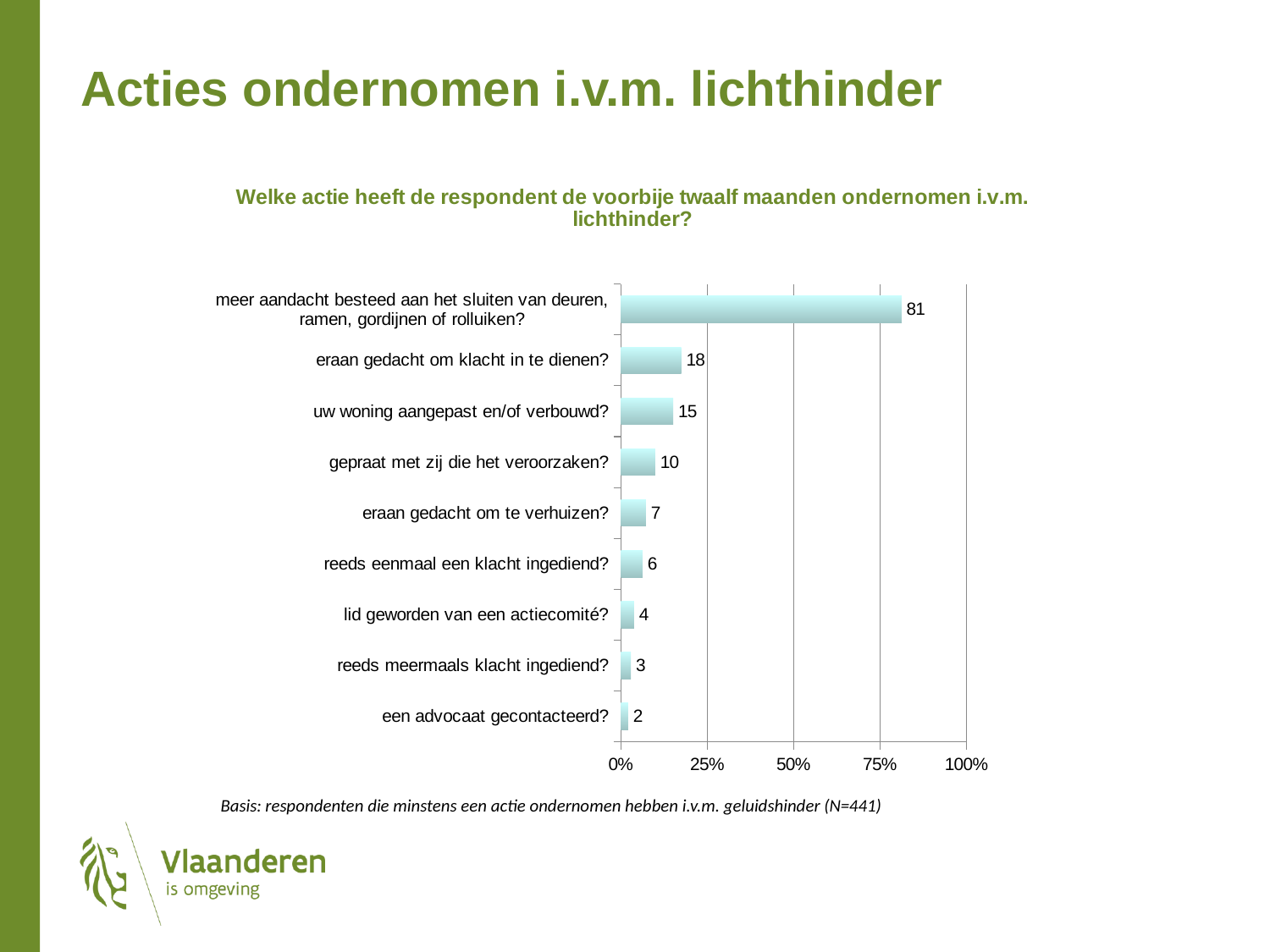
What is the difference between the values for 'eraan gedacht om klacht in te dienen?' and 'uw woning aangepast en/of verbouwd?' 3 What kind of chart is shown on the slide? bar chart Is the value for 'meer aandacht besteed aan het sluiten van deuren, ramen, gordijnen of rolluiken?' greater or less than 75%? greater What value is shown for 'een advocaat gecontacteerd?' 2 What value is shown for 'gepraat met zij die het veroorzaken?' 10 What value is shown for 'eraan gedacht om klacht in te dienen?' 18 Which category has the lowest value? een advocaat gecontacteerd? What value is shown for 'uw woning aangepast en/of verbouwd?' 15 How many categories are shown in the chart? 9 Which category has the highest value? meer aandacht besteed aan het sluiten van deuren, ramen, gordijnen of rolluiken? Which is larger: the value for 'eraan gedacht om te verhuizen?' or 'reeds eenmaal een klacht ingediend?' eraan gedacht om te verhuizen? What is the N (number of respondents) stated in the note below the chart? 441